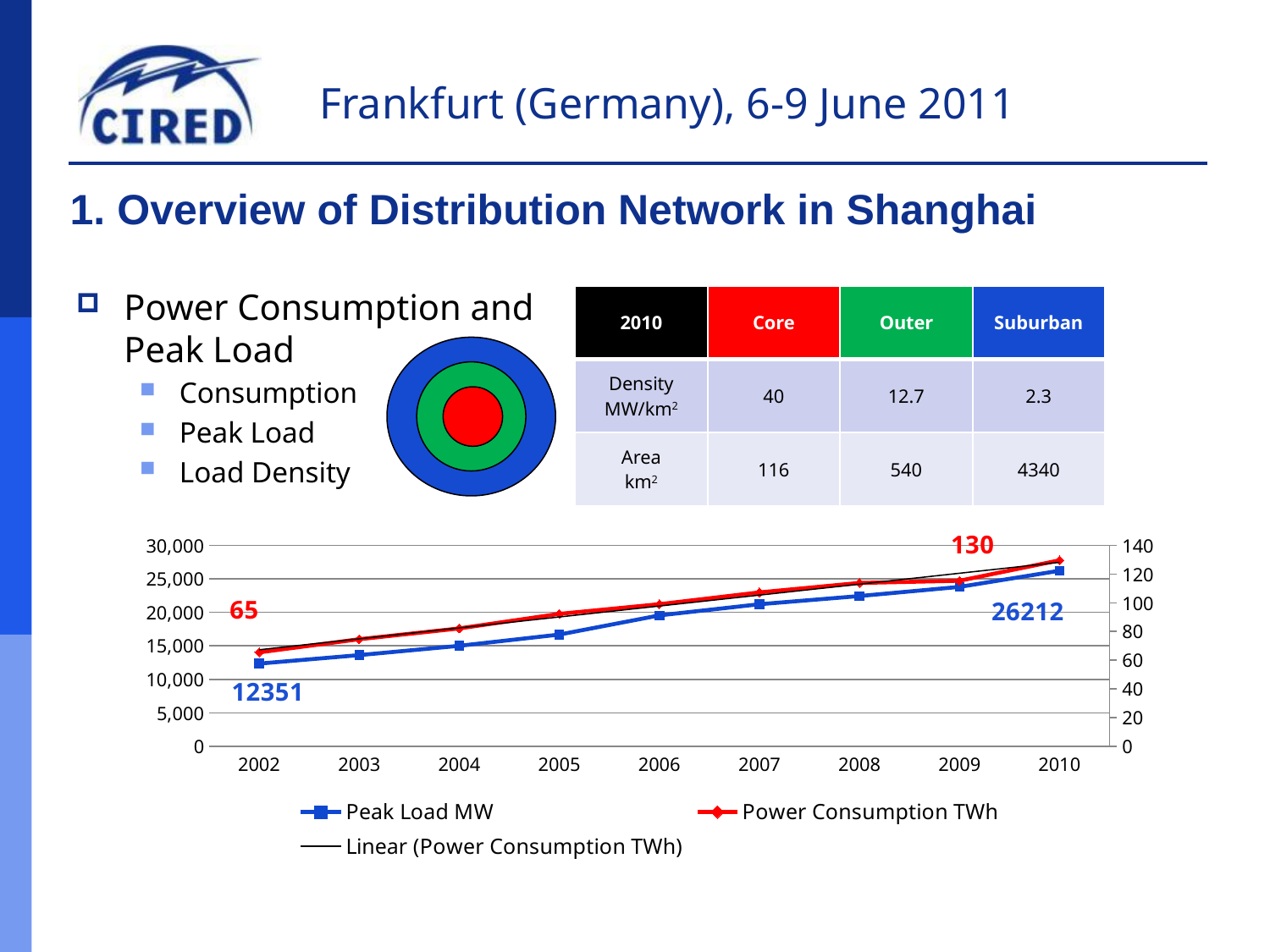
By how much did Peak Load MW increase from 2002 to 2010? 13861 Does Peak Load MW rise or fall from 2002 to 2010? rise Is the Peak Load MW value for 2005 greater or less than 20,000? less What is the Power Consumption TWh value in 2010? 130 What kind of chart is shown on the slide? line chart How many entries does the chart legend list? 3 What is the Peak Load MW value in 2002? 12351 By how much did Power Consumption TWh increase from 2002 to 2010? 65 Which year has the highest Peak Load MW? 2010 How many years are shown on the x axis of the chart? 9 What is the Power Consumption TWh value in 2002? 65 What is the Peak Load MW value in 2010? 26212